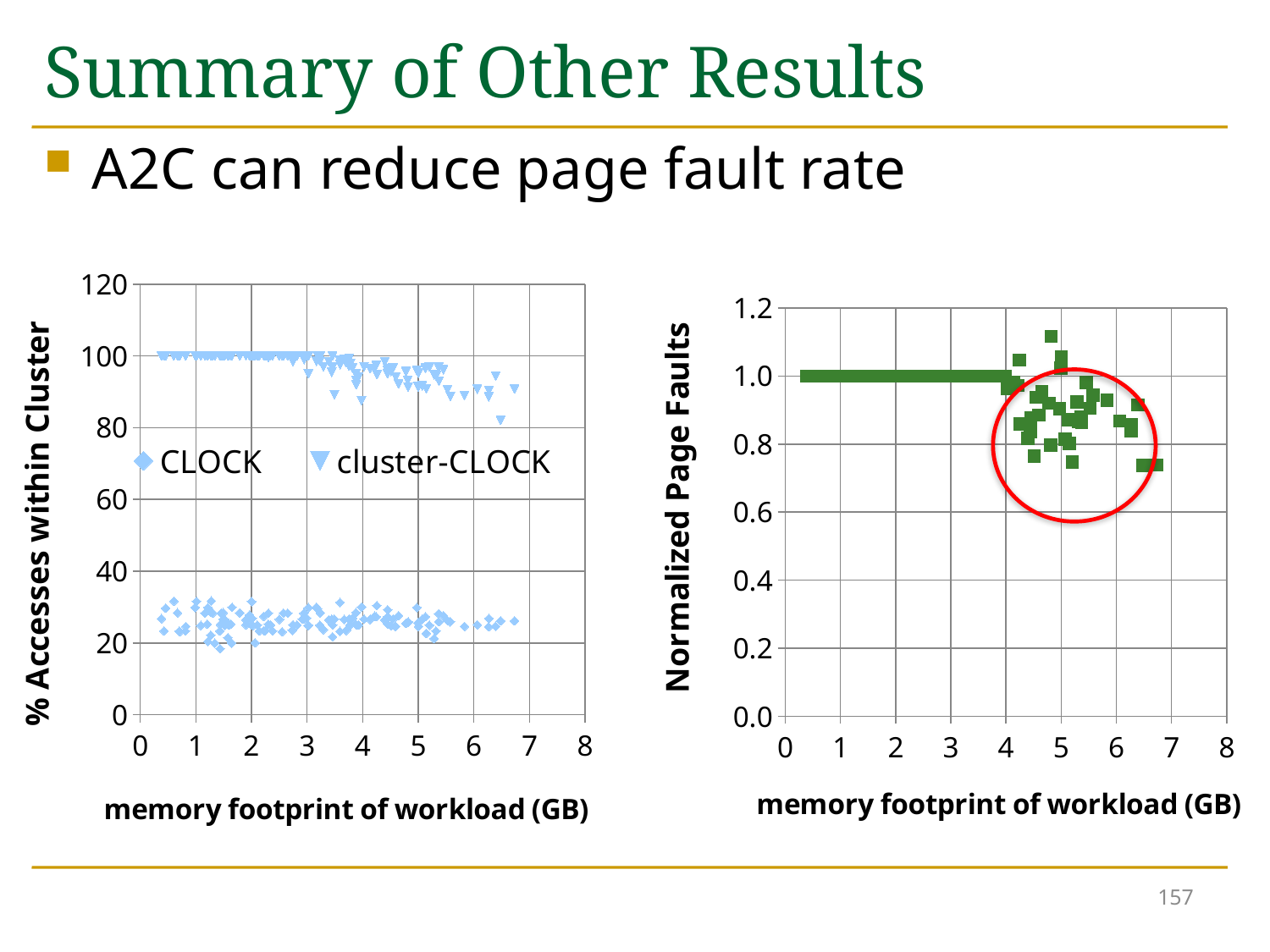
How many series does the legend of the left chart list? 2 In the right chart, are the Normalized Page Faults values for memory footprints below 4 GB greater or less than 0.8? greater In the left chart, are the CLOCK values greater or less than 40? less In the right chart, do the Normalized Page Faults values generally rise or fall as the memory footprint increases beyond 4 GB? fall What kind of chart is the right chart on the slide? scatter chart In the left chart, are the cluster-CLOCK values at a memory footprint of 1 GB greater or less than 80? greater What is the x-axis label of the left chart? memory footprint of workload (GB) What is the maximum value shown on the y-axis of the left chart? 120 What is the y-axis label of the right chart? Normalized Page Faults What kind of chart is the left chart on the slide? scatter chart In the left chart, which series has the higher % Accesses within Cluster values, CLOCK or cluster-CLOCK? cluster-CLOCK